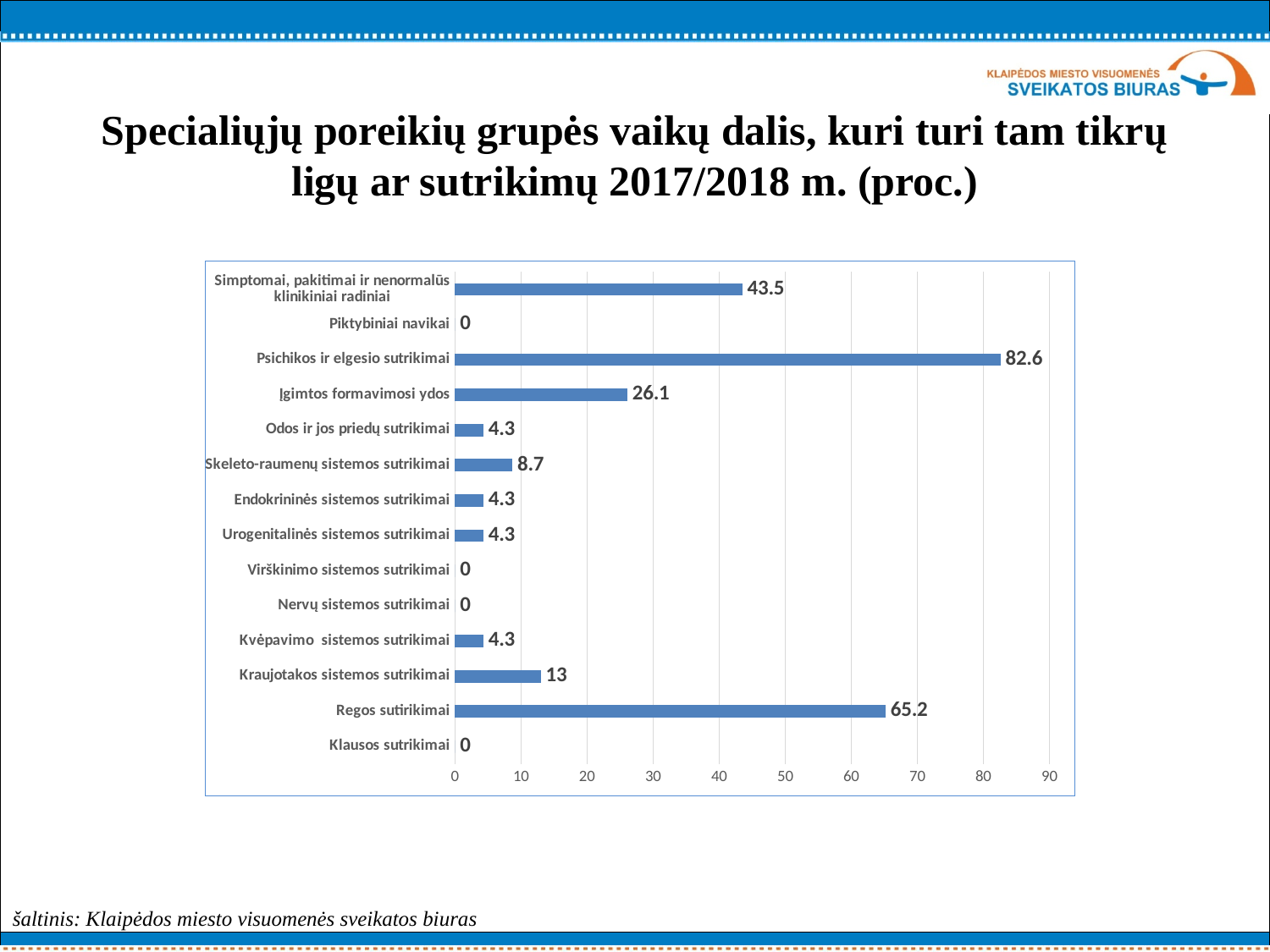
What kind of chart is shown on the slide? bar chart What is the value for Skeleto-raumenų sistemos sutrikimai? 8.7 Is the value for Regos sutrikimai greater or less than 60? greater What is the value for Regos sutrikimai? 65.2 What is the difference between the values for Psichikos ir elgesio sutrikimai and Regos sutrikimai? 17.4 What is the value for Psichikos ir elgesio sutrikimai? 82.6 What is the value for Kraujotakos sistemos sutrikimai? 13 How many categories are shown in the chart? 14 What is the value for Įgimtos formavimosi ydos? 26.1 Which category has the highest value? Psichikos ir elgesio sutrikimai Which is larger, the value for Regos sutrikimai or the value for Simptomai, pakitimai ir nenormalūs klinikiniai radiniai? Regos sutrikimai What is the difference between the values for Kraujotakos sistemos sutrikimai and Skeleto-raumenų sistemos sutrikimai? 4.3